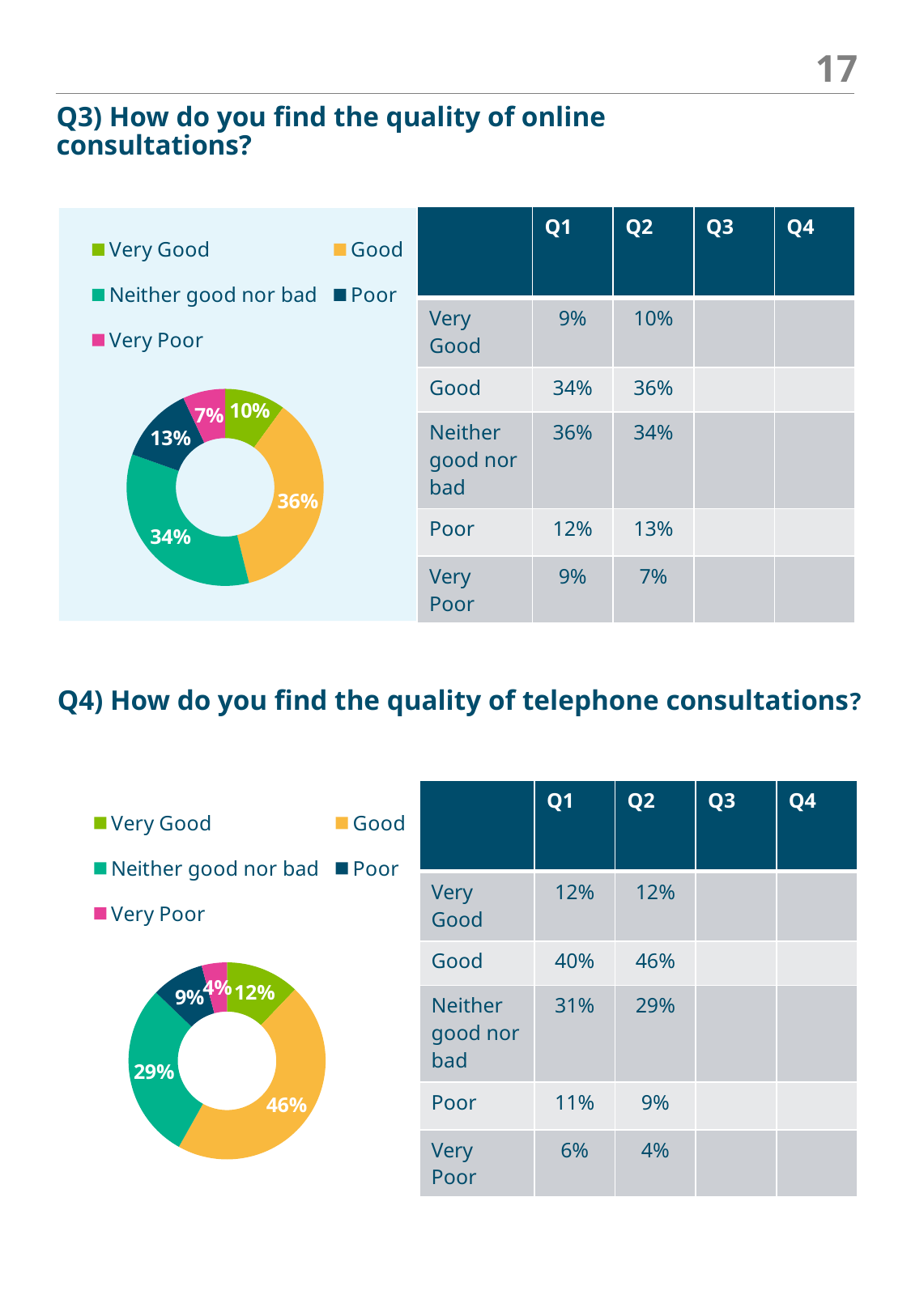
In the Q3 online consultations chart, which category has the smallest slice? Very Poor In the Q4 telephone consultations chart, which is larger: Very Good or Poor? Very Good In the Q3 online consultations chart, which category has the largest slice? Good In the Q3 online consultations chart, what share of the pie is labelled Good? 36% In the Q3 online consultations chart, what is the value for Very Poor? 7% What kind of chart is used for the Q4 telephone consultations question? Pie chart (donut) In the Q4 telephone consultations chart, which category has the smallest slice? Very Poor In the Q3 online consultations chart, how many categories does the legend list? 5 In the Q4 telephone consultations chart, what is the value for Good? 46% In the Q3 online consultations chart, what is the difference between the Neither good nor bad slice and the Poor slice? 21% In the Q4 telephone consultations chart, what colour is the Good slice? Yellow/orange In the Q4 telephone consultations chart, what is the value for Neither good nor bad? 29%